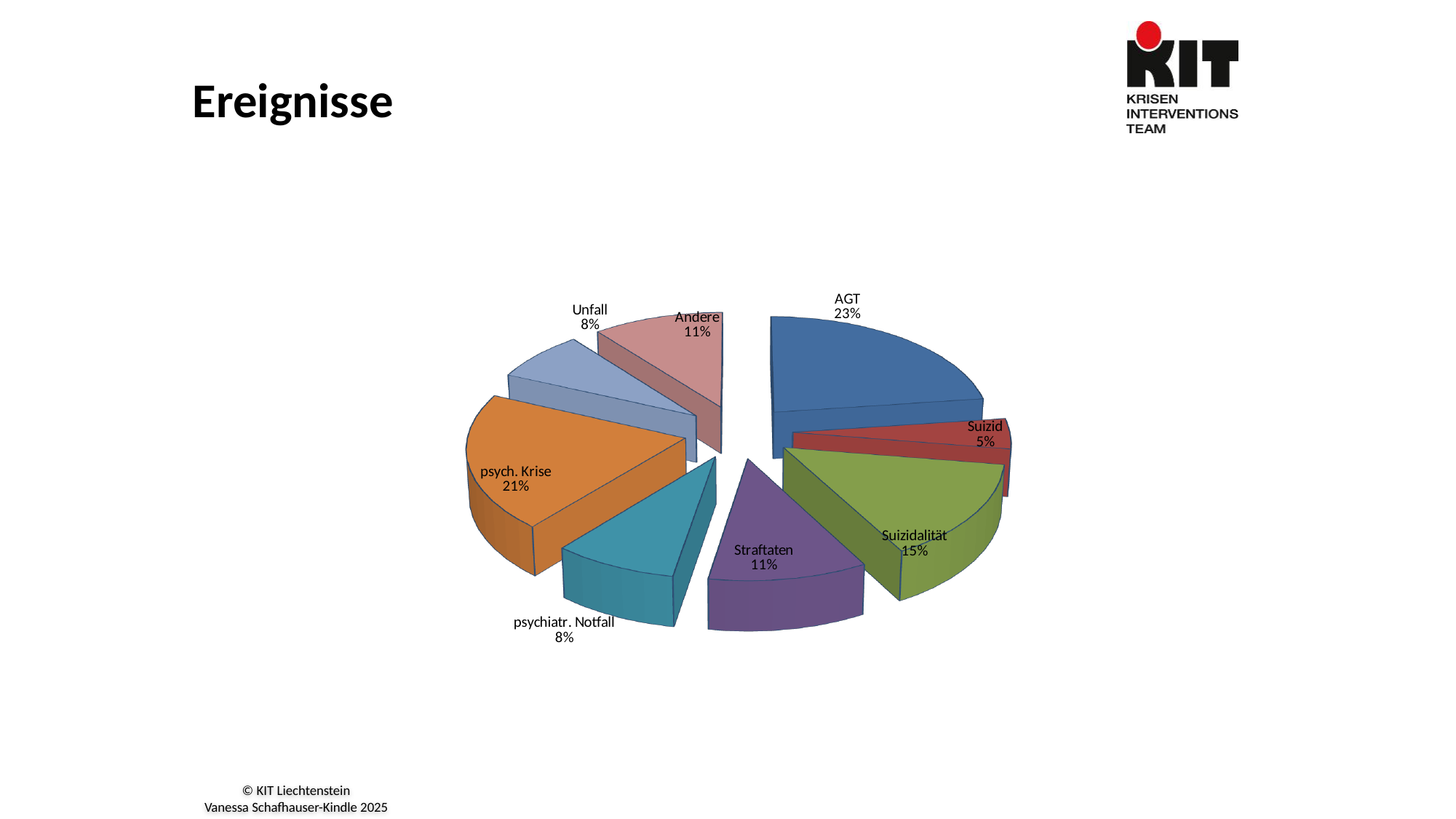
What share of the pie does Suizid have? 5% What share of the pie does Suizidalität have? 15% What share of the pie does AGT have? 23% Which is larger, the share for Straftaten or the share for Unfall? Straftaten What share of the pie does psychiatr. Notfall have? 8% What is the title of the slide containing the pie chart? Ereignisse What is the difference in percentage points between AGT and Suizidalität? 8 Which category has the smallest share of the pie? Suizid What share of the pie does psych. Krise have? 21% How many categories (slices) does the pie chart have? 8 What kind of chart is shown on the slide? pie chart Which category has the largest share of the pie? AGT